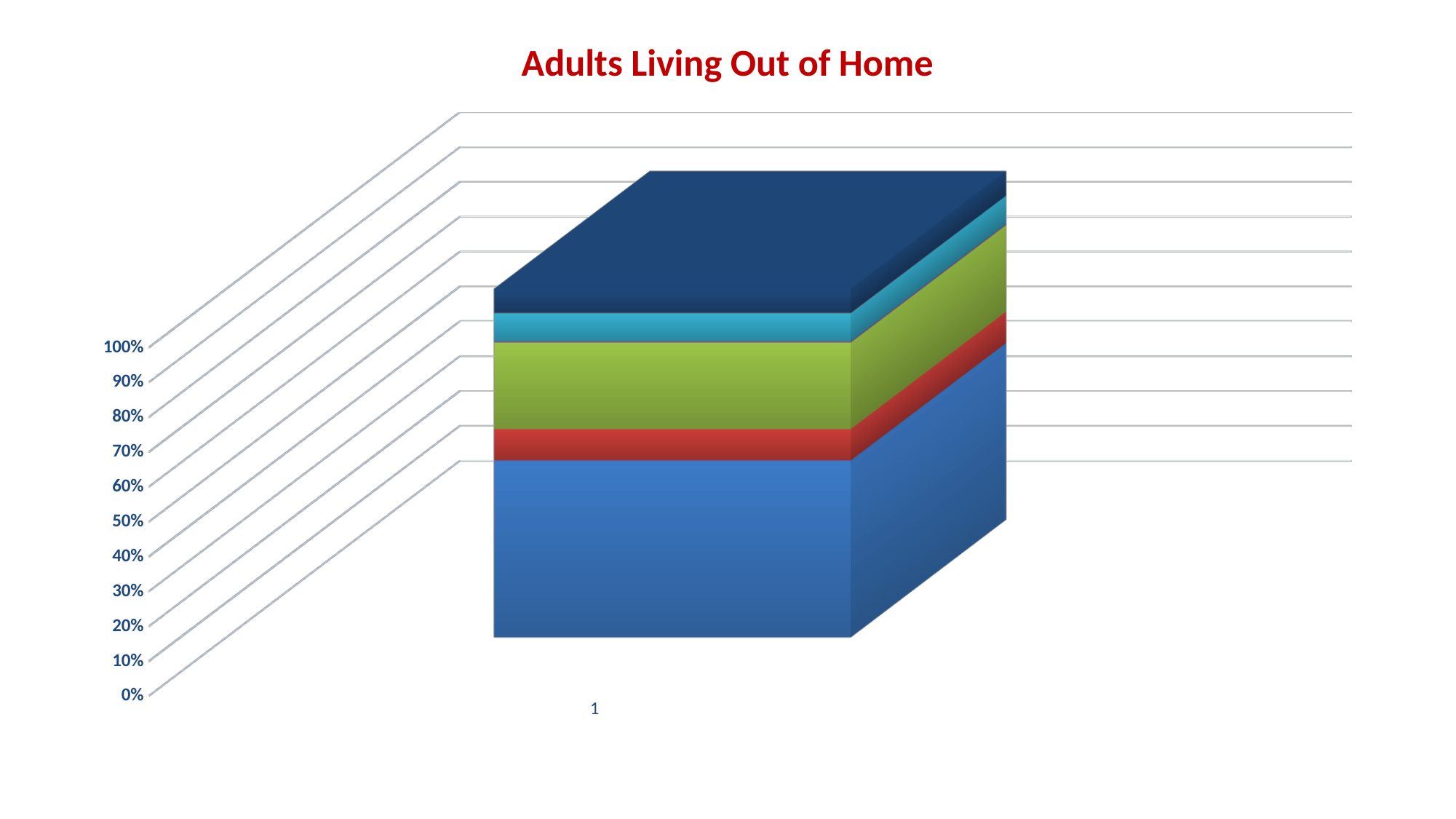
How many categories are plotted on the x axis of the chart? 1 Is the value of the red segment greater or less than 20%? less Is the value of the green segment greater or less than 10%? greater Which is larger, the bottom blue segment or the green segment? The bottom blue segment Is the value of the bottom blue segment greater or less than 40%? greater What is the label of the single category on the x axis? 1 What is the title of the chart? Adults Living Out of Home What kind of chart is shown on the slide? Bar chart Which is larger, the green segment or the red segment? The green segment Which segment of the stacked bar is the largest? The bottom blue segment